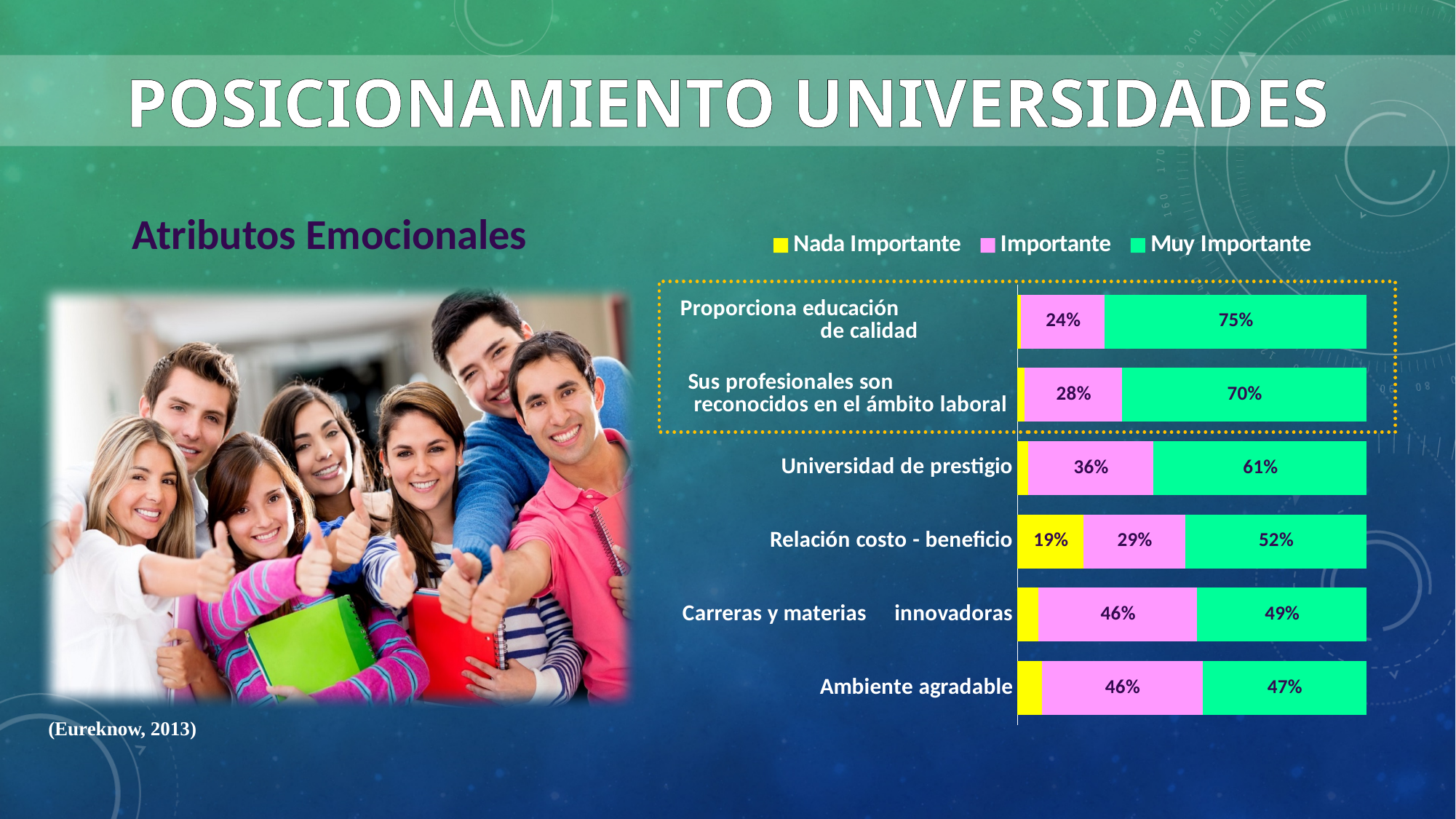
Which category has the highest 'Muy Importante' value? Proporciona educación de calidad What is the difference between the 'Muy Importante' values for 'Universidad de prestigio' and 'Relación costo - beneficio'? 9% How many categories (attributes) are plotted in the chart? 6 Which legend entry is shown in yellow? Nada Importante What is the 'Importante' value for 'Sus profesionales son reconocidos en el ámbito laboral'? 28% Which is larger: the 'Importante' value for 'Universidad de prestigio' or for 'Relación costo - beneficio'? Universidad de prestigio How many series does the chart legend list? 3 Which category has the lowest 'Muy Importante' value? Ambiente agradable What is the 'Nada Importante' value for 'Relación costo - beneficio'? 19% What is the total of the three segments for 'Relación costo - beneficio'? 100% What is the 'Muy Importante' value for 'Proporciona educación de calidad'? 75% What kind of chart is shown on the slide? stacked bar chart